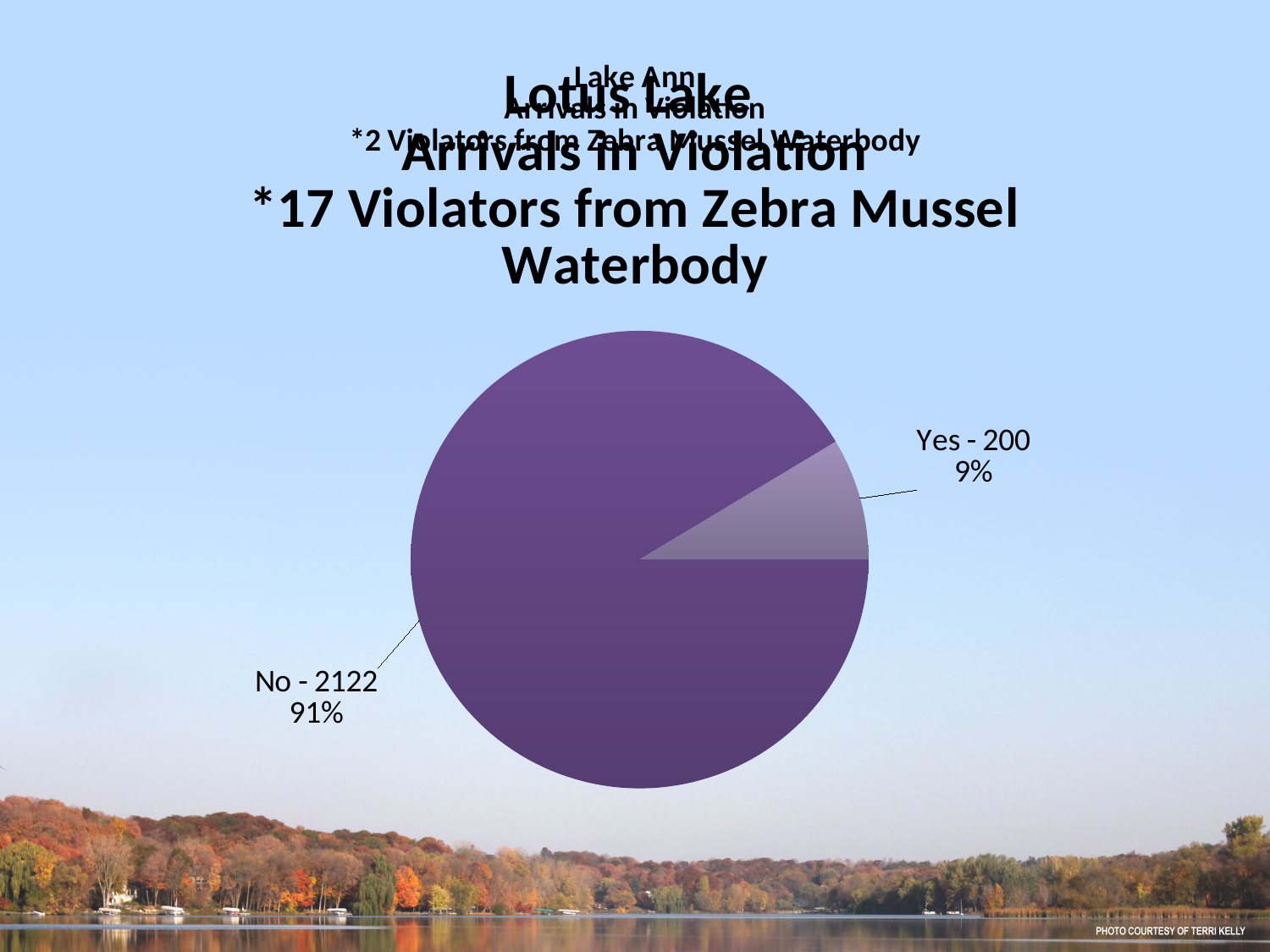
What is the total of the "Yes" and "No" values in the pie chart? 2322 How many slices does the pie chart have? 2 What share of the pie does the "Yes" slice represent? 9% What is the value for the "Yes" slice of the pie chart? 200 What share of the pie does the "No" slice represent? 91% Which slice of the pie chart is the smallest? Yes Which slice of the pie chart is shown in the lighter purple colour? Yes What kind of chart is shown on the slide? pie chart Which is larger, the value for "Yes" or the value for "No"? No What is the difference between the "No" value and the "Yes" value? 1922 Which slice of the pie chart is the largest? No What is the value for the "No" slice of the pie chart? 2122